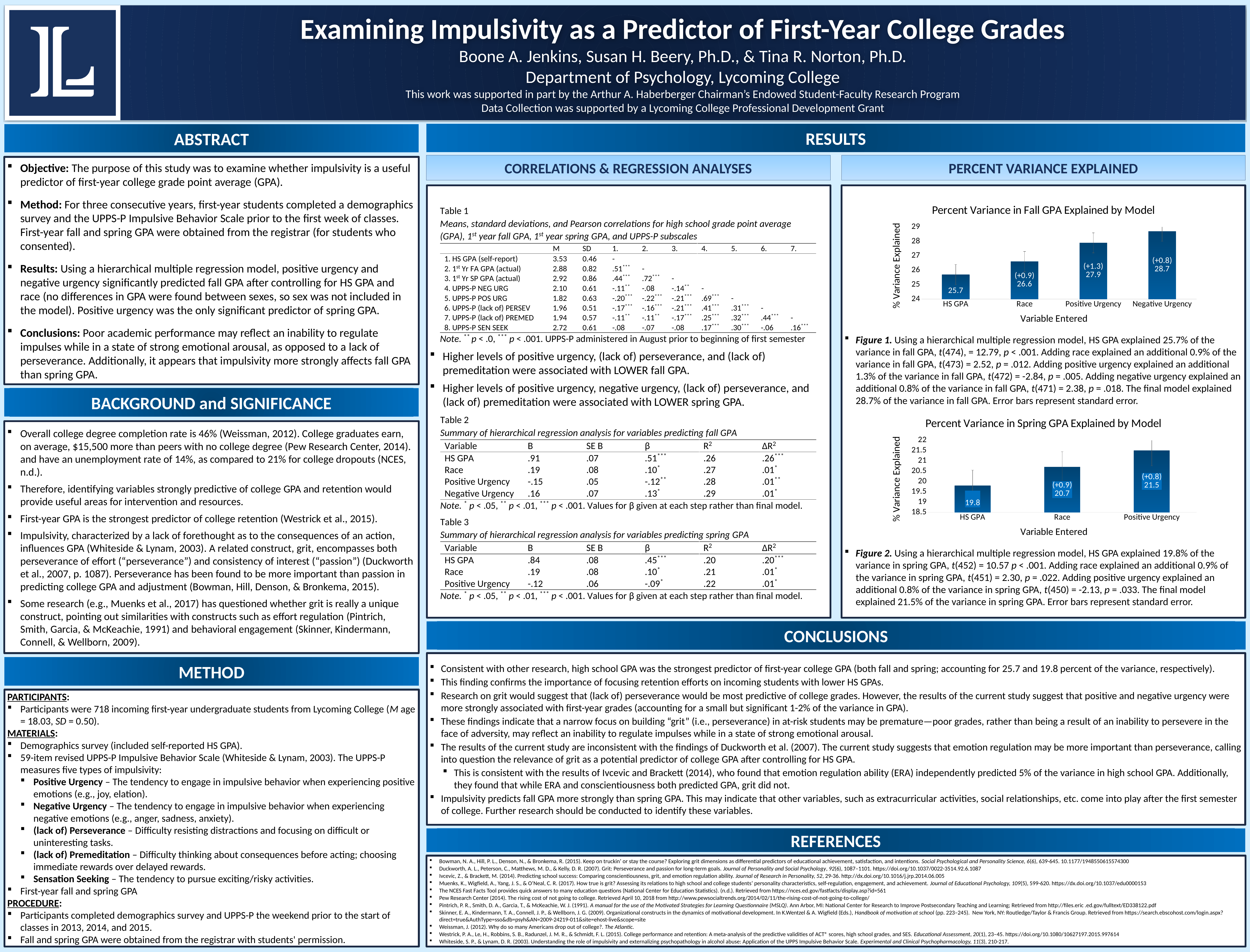
In the 'Percent Variance in Fall GPA Explained by Model' chart, what is the value for Negative Urgency? 28.7 In the 'Percent Variance in Fall GPA Explained by Model' chart, what is the value for HS GPA? 25.7 In the 'Percent Variance in Spring GPA Explained by Model' chart, what is the value for Positive Urgency? 21.5 In the 'Percent Variance in Fall GPA Explained by Model' chart, how many variables are plotted on the x axis? 4 In the 'Percent Variance in Fall GPA Explained by Model' chart, what is the difference between the values for Positive Urgency and Race? 1.3 In the 'Percent Variance in Spring GPA Explained by Model' chart, what is the value for Race? 20.7 In the 'Percent Variance in Spring GPA Explained by Model' chart, how many variables are plotted on the x axis? 3 In the 'Percent Variance in Fall GPA Explained by Model' chart, do the values rise or fall from left to right along the x axis? rise What kind of chart is the 'Percent Variance in Spring GPA Explained by Model' chart? bar chart In the 'Percent Variance in Fall GPA Explained by Model' chart, which variable has the lowest value? HS GPA In the 'Percent Variance in Fall GPA Explained by Model' chart, which variable has the highest value? Negative Urgency In the 'Percent Variance in Spring GPA Explained by Model' chart, what is the difference between the values for Positive Urgency and HS GPA? 1.7